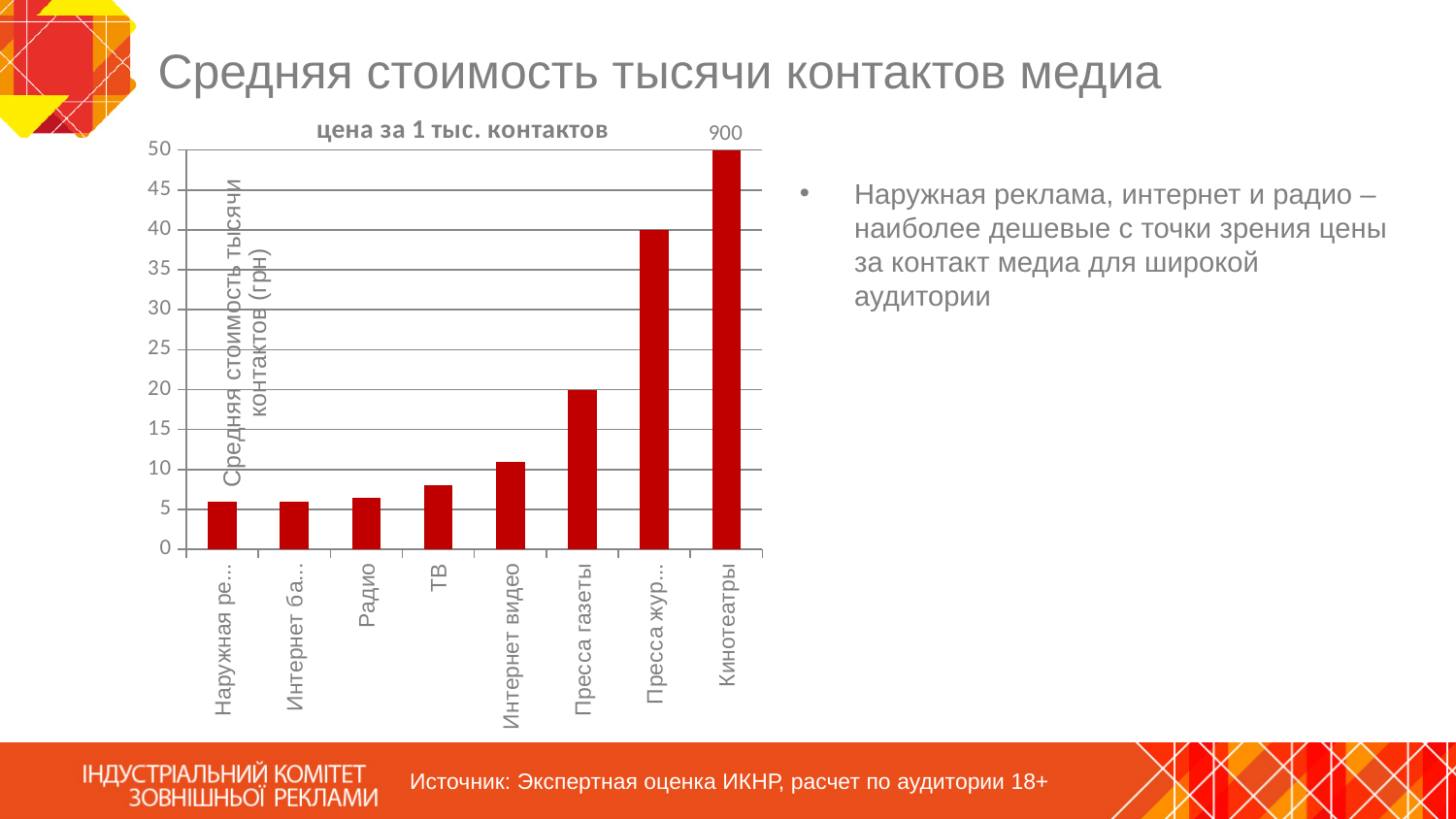
Do the values rise or fall moving from left to right along the x axis? rise Is the value for Радио greater or less than 10? less Is the value for Пресса жур... greater or less than 30? greater What value is printed for Кинотеатры? 900 Which is larger, the value for Пресса газеты or the value for ТВ? Пресса газеты What is the title of the chart? цена за 1 тыс. контактов Which category has the highest value in the chart? Кинотеатры Which is larger, the value for Интернет видео or the value for Радио? Интернет видео Is the value for Пресса газеты greater or less than 15? greater How many categories are plotted on the x axis of the chart? 8 What kind of chart is shown on the slide? bar chart